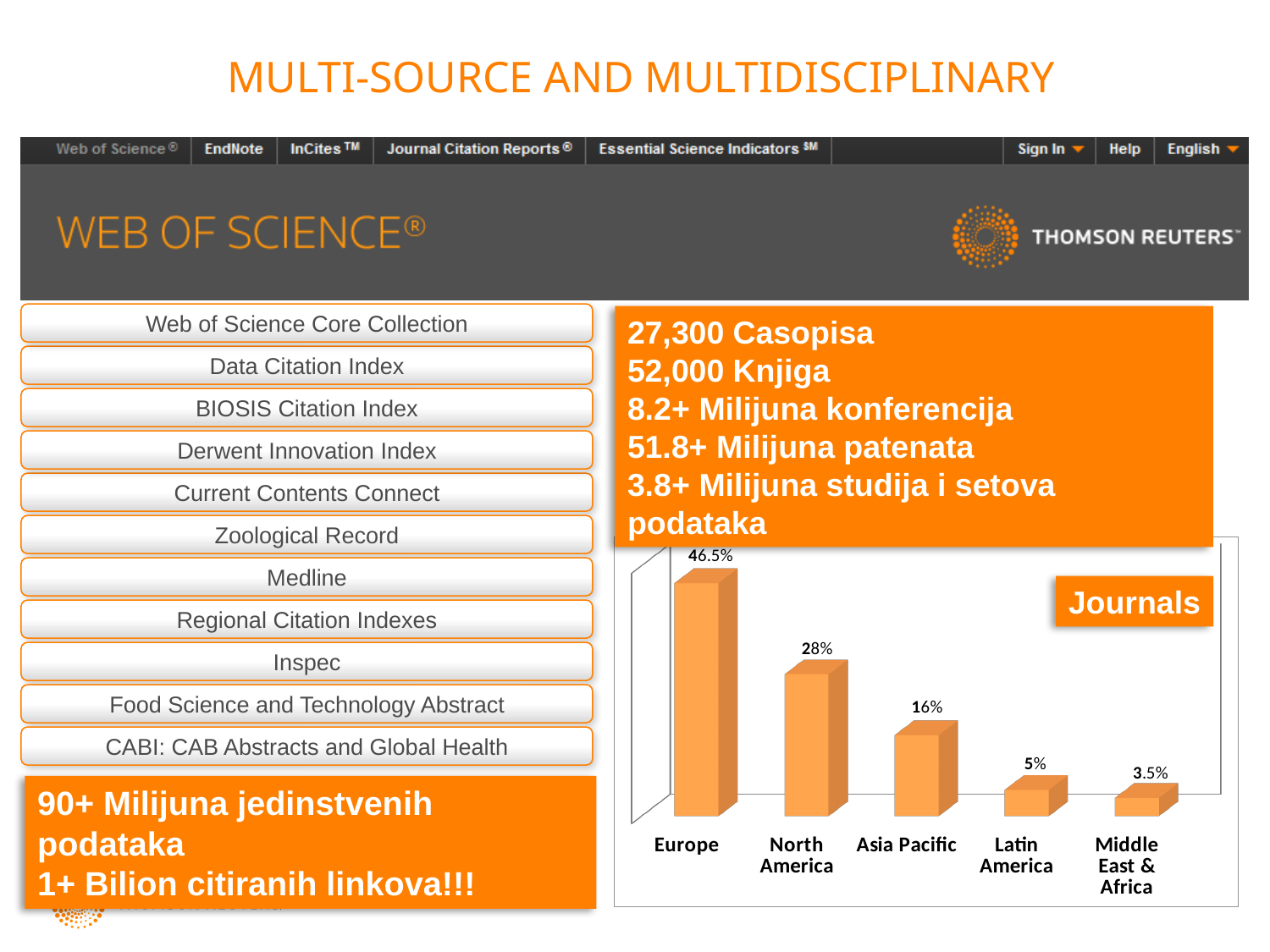
Which is larger in the Journals chart, Asia Pacific or Latin America? Asia Pacific What is the value for Middle East & Africa in the Journals chart? 3.5% How many regions are shown in the Journals chart? 5 What is the value for Europe in the Journals chart? 46.5% Which region has the highest value in the Journals chart? Europe What kind of chart is the Journals chart? Bar chart Do the values in the Journals chart rise or fall from left to right? Fall What is the value for Asia Pacific in the Journals chart? 16% What is the difference between the values for Latin America and Middle East & Africa in the Journals chart? 1.5% Which region has the lowest value in the Journals chart? Middle East & Africa What is the value for North America in the Journals chart? 28% What is the difference between the values for Europe and North America in the Journals chart? 18.5%